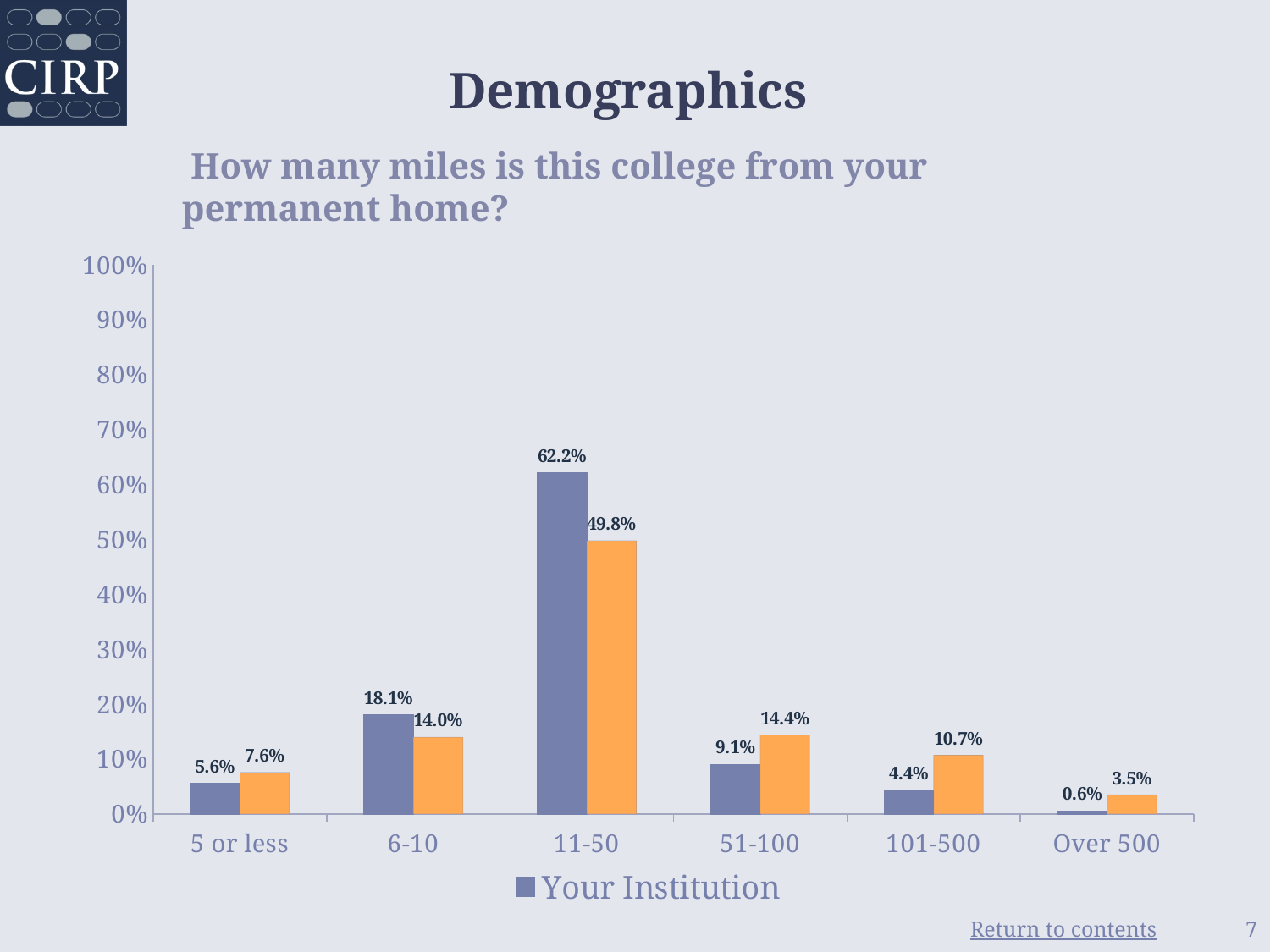
What kind of chart is shown on the slide? bar chart What is the value for Your Institution in the 11-50 category? 62.2% What is the difference between the Your Institution values for 11-50 and 6-10? 44.1% Which category has the highest value for Your Institution? 11-50 How many distance categories are shown on the x axis? 6 What is the value for Your Institution in the Over 500 category? 0.6% How many series does the legend list? 1 What is the value for Your Institution in the 6-10 category? 18.1% For Your Institution, which category has the larger value: 5 or less or 51-100? 51-100 What is the value shown on the orange bar for the 11-50 category? 49.8% Is the Your Institution value for 11-50 greater or less than 50%? greater Which category has the lowest value for Your Institution? Over 500